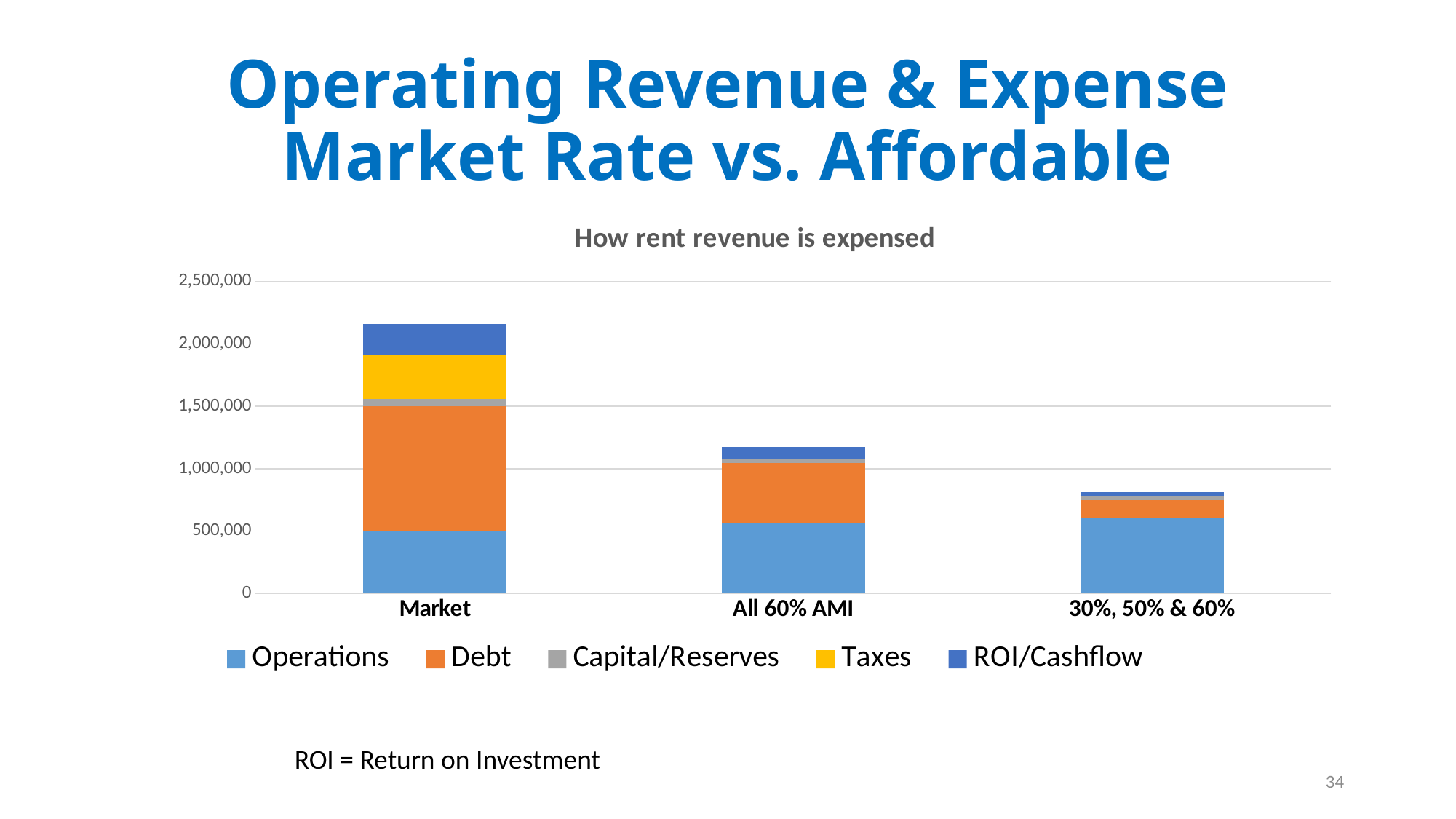
What kind of chart is shown on the slide? Stacked bar chart Is the total of the 30%, 50% & 60% bar greater or less than 1,000,000? less Which category has the shortest stacked bar? 30%, 50% & 60% Do the stacked bar totals rise or fall from left to right across the x axis? fall How many categories are shown on the x axis of the chart? 3 Is the total of the 30%, 50% & 60% bar greater or less than 500,000? greater Which bar is taller, All 60% AMI or 30%, 50% & 60%? All 60% AMI Is the total of the All 60% AMI bar greater or less than 1,000,000? greater What is the title of the chart? How rent revenue is expensed Which category has the tallest stacked bar? Market How many series does the chart legend list? 5